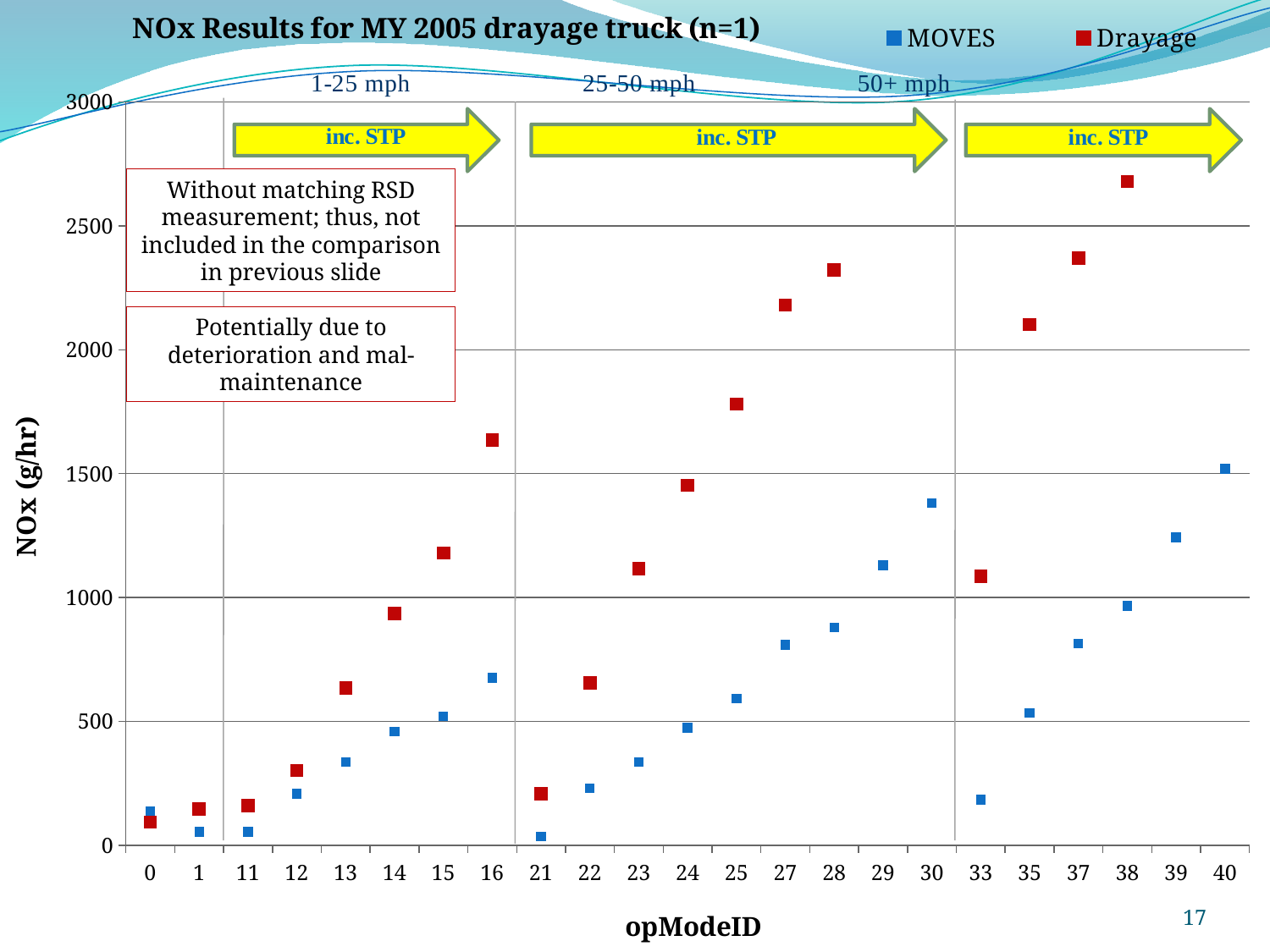
What is the label of the y axis? NOx (g/hr) Which opModeID has the lowest MOVES value? 21 How many opModeID categories are shown on the x axis? 23 Is the Drayage value for opModeID 16 greater or less than 1500? greater At opModeID 33, which series has the larger value, MOVES or Drayage? Drayage Is the Drayage value for opModeID 28 greater or less than 2000? greater Do the MOVES values rise or fall from opModeID 21 to opModeID 30? rise Which opModeID has the highest MOVES value? 40 How many series does the legend list? 2 Which opModeID has the highest Drayage value? 38 What kind of chart is shown on the slide? scatter chart Is the MOVES value for opModeID 30 greater or less than 1500? less